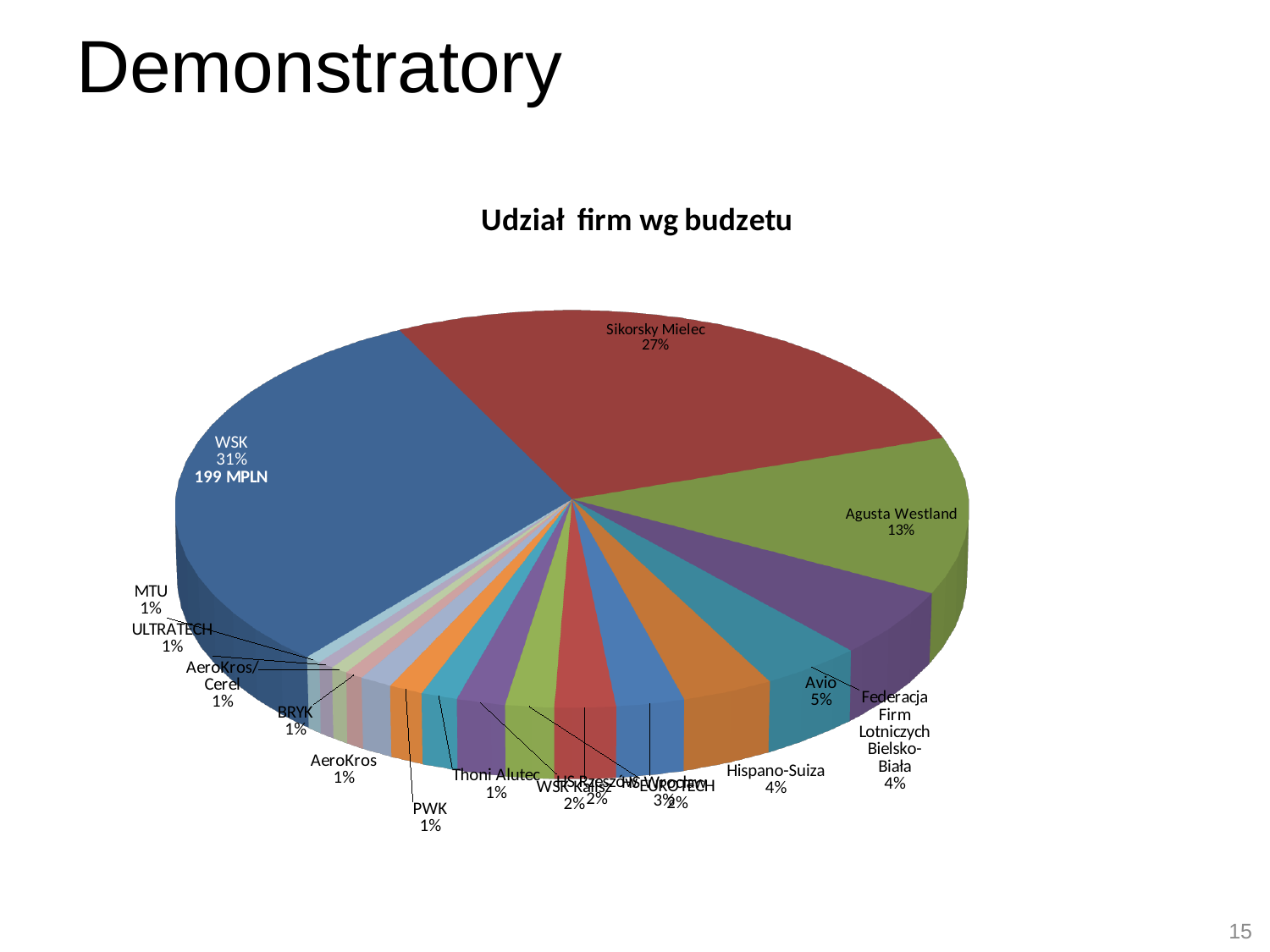
What share of the pie does Sikorsky Mielec hold? 27% What share of the pie does Avio hold? 5% What kind of chart is shown on the slide? pie chart What is the difference in percentage points between the WSK and Sikorsky Mielec shares? 4 What share of the pie does WSK hold? 31% What budget value is printed next to the WSK slice? 199 MPLN Which company has the largest slice of the pie? WSK Which slice is larger, Agusta Westland or Avio? Agusta Westland What is the title of the chart? Udział firm wg budzetu